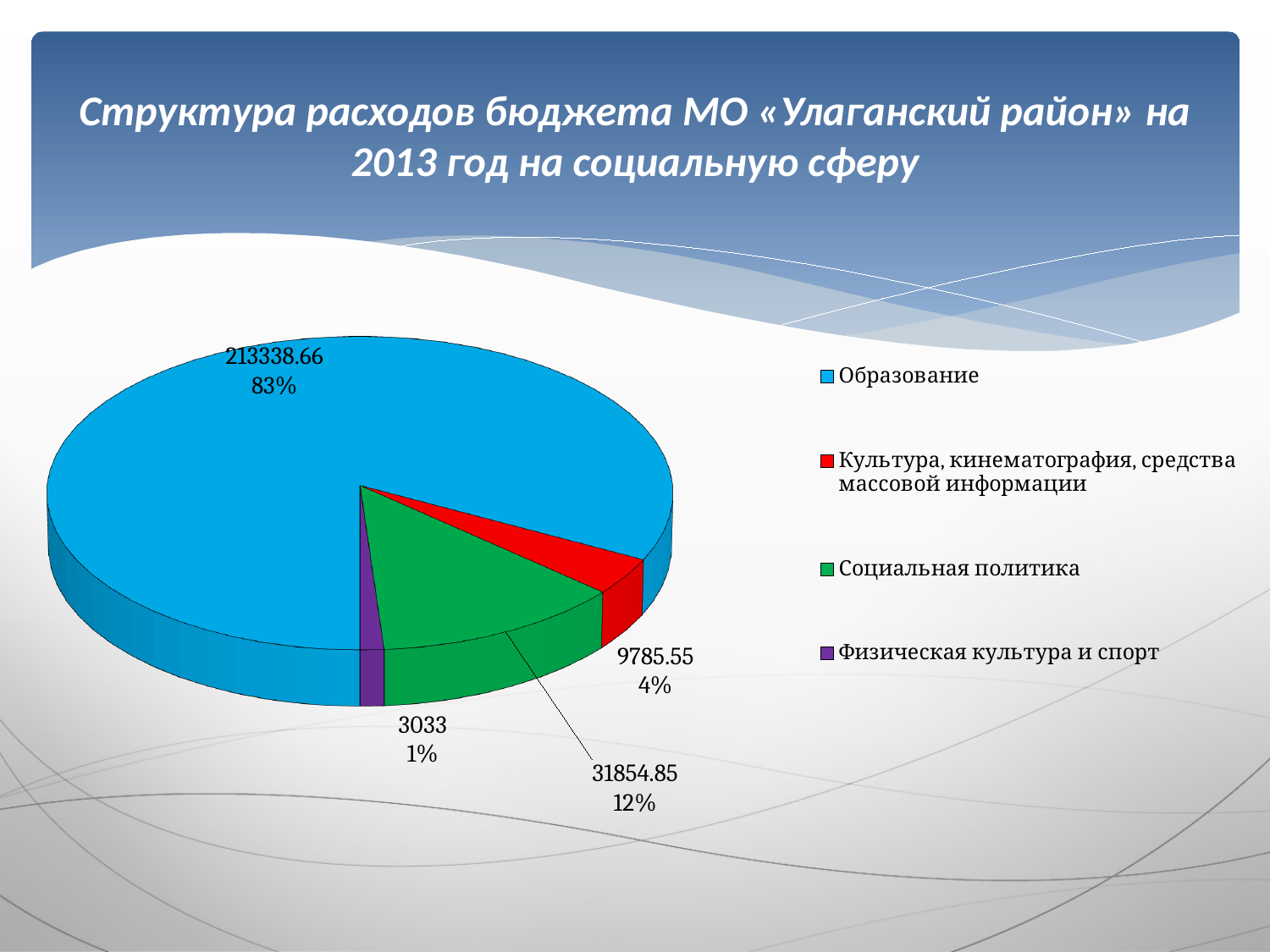
What is the value for Социальная политика? 31854.85 Which category has the largest slice? Образование How many categories does the legend list? 4 What is the value for Физическая культура и спорт? 3033 What is the value for Культура, кинематография, средства массовой информации? 9785.55 What is the value for Образование? 213338.66 What is the difference between the values for Образование and Социальная политика? 181483.81 Which is larger, Социальная политика or Культура, кинематография, средства массовой информации? Социальная политика What share of the pie does Социальная политика take? 12% What share of the pie does Образование take? 83% What kind of chart is shown on the slide? pie chart Which category has the smallest slice? Физическая культура и спорт